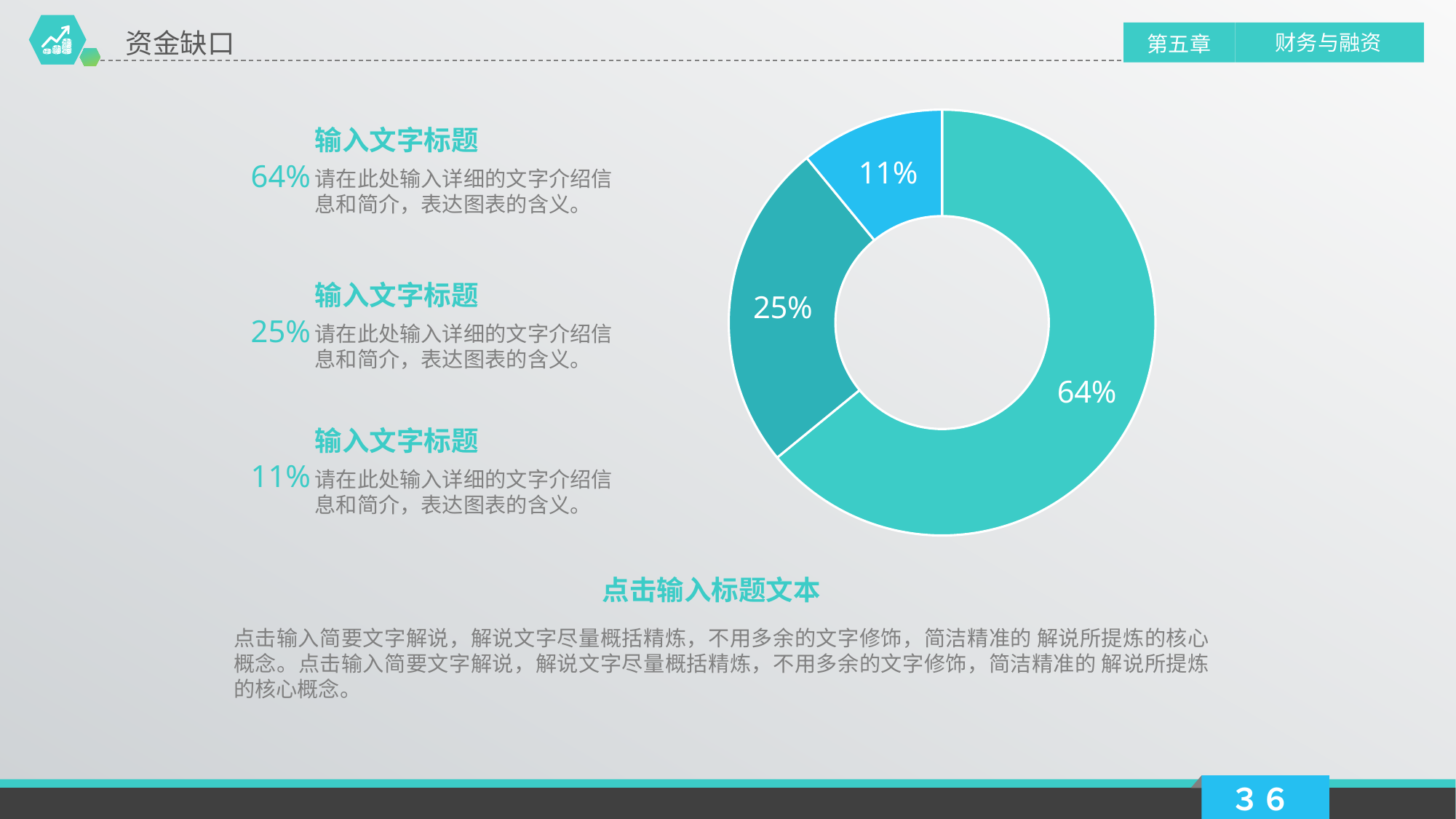
What is the value of the smallest slice in the doughnut chart? 11% What value is shown on the large teal slice on the right of the doughnut chart? 64% What is the difference in percentage points between the 64% slice and the 25% slice? 39 What value is shown on the light blue slice at the top of the doughnut chart? 11% What is the title shown at the top left of the slide? 资金缺口 What is the difference in percentage points between the 25% slice and the 11% slice? 14 What value is shown on the dark teal slice on the left of the doughnut chart? 25% What is the value of the largest slice in the doughnut chart? 64% What kind of chart is shown on the slide? Doughnut chart Which slice is larger, the dark teal slice on the left or the light blue slice at the top? The dark teal slice on the left How many slices does the doughnut chart have? 3 What do the three slice values of the doughnut chart add up to? 100%